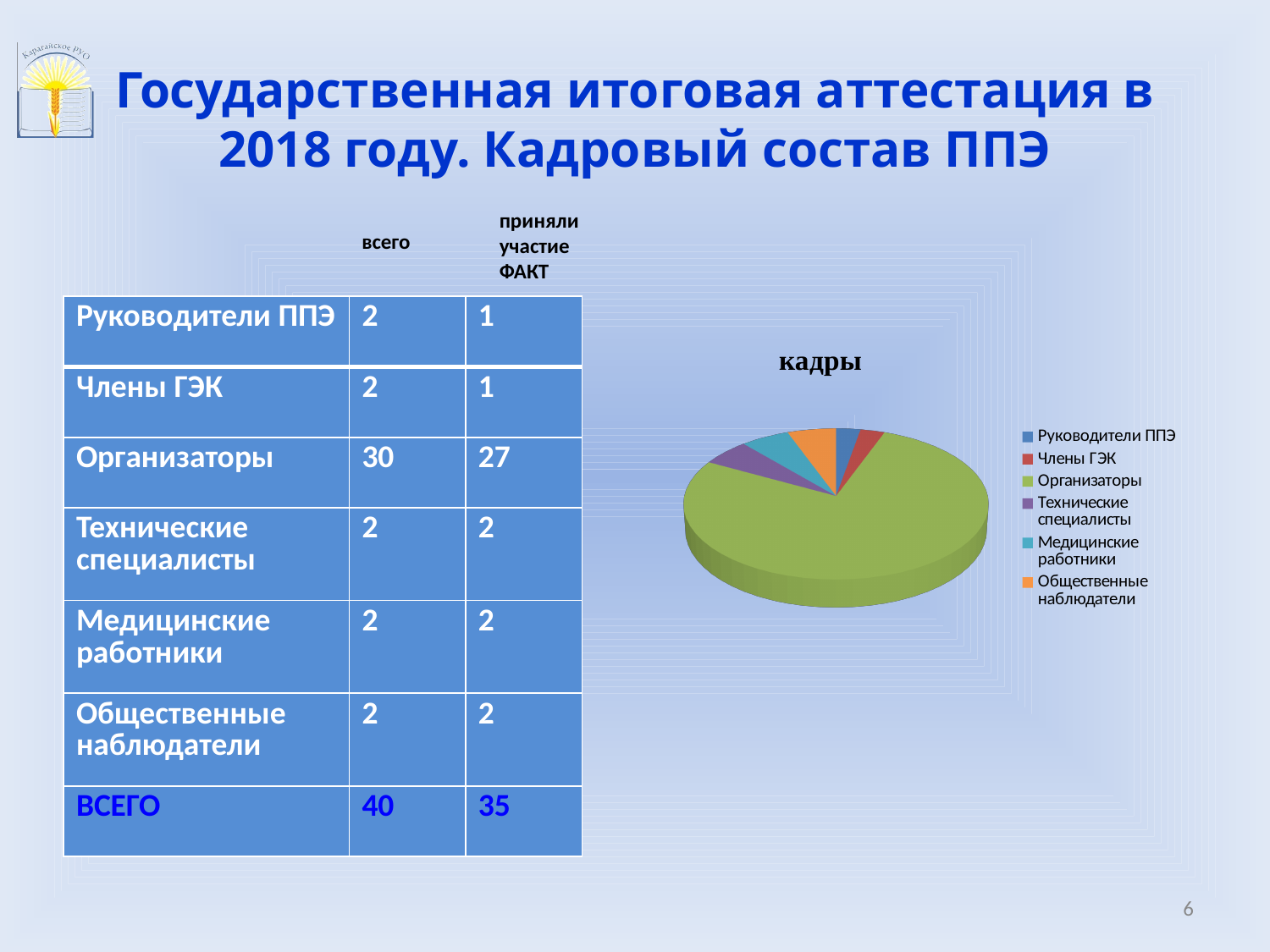
What is the title of the pie chart? кадры Which slice is larger in the pie chart: Организаторы or Члены ГЭК? Организаторы Which slice is larger in the pie chart: Организаторы or Общественные наблюдатели? Организаторы How many categories does the legend of the pie chart list? 6 Does the Организаторы slice take up more or less than half of the pie chart? more What kind of chart is shown on the slide? pie chart Which category has the largest slice in the pie chart? Организаторы Which colour represents Организаторы in the pie chart? green